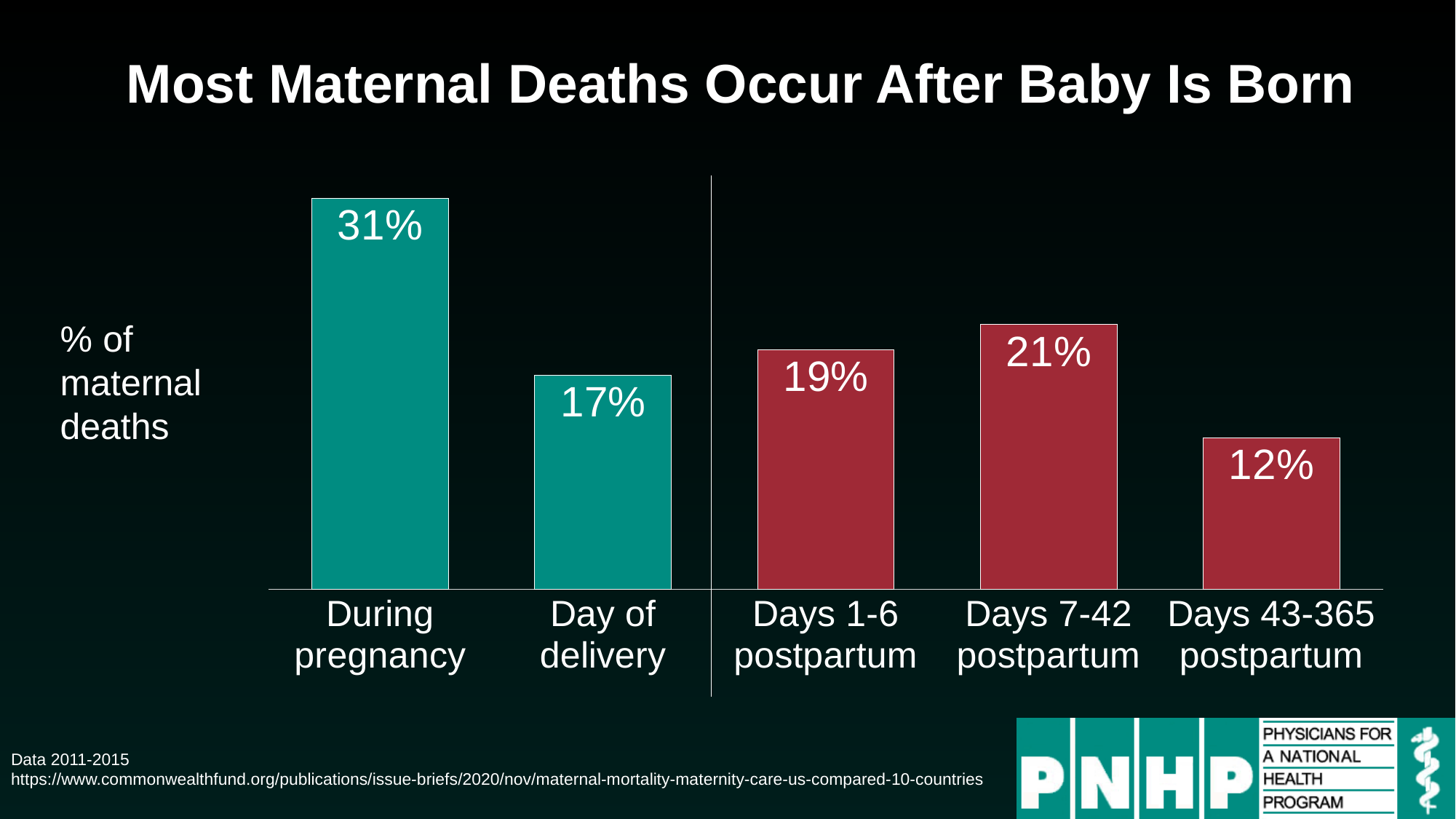
Which period has the highest percentage of maternal deaths? During pregnancy What percentage of maternal deaths occur in days 43-365 postpartum? 12% What type of chart is shown on the slide? Bar chart What is the title of the chart? Most Maternal Deaths Occur After Baby Is Born How many time periods are shown in the chart? 5 What is the difference in percentage points between deaths during pregnancy and deaths on the day of delivery? 14 What percentage of maternal deaths occur during pregnancy? 31% What percentage of maternal deaths occur on the day of delivery? 17% What percentage of maternal deaths occur in days 7-42 postpartum? 21% What is the combined percentage of maternal deaths for the three postpartum periods? 52% Which period has the lowest percentage of maternal deaths? Days 43-365 postpartum Which is larger: the percentage for days 1-6 postpartum or days 7-42 postpartum? Days 7-42 postpartum